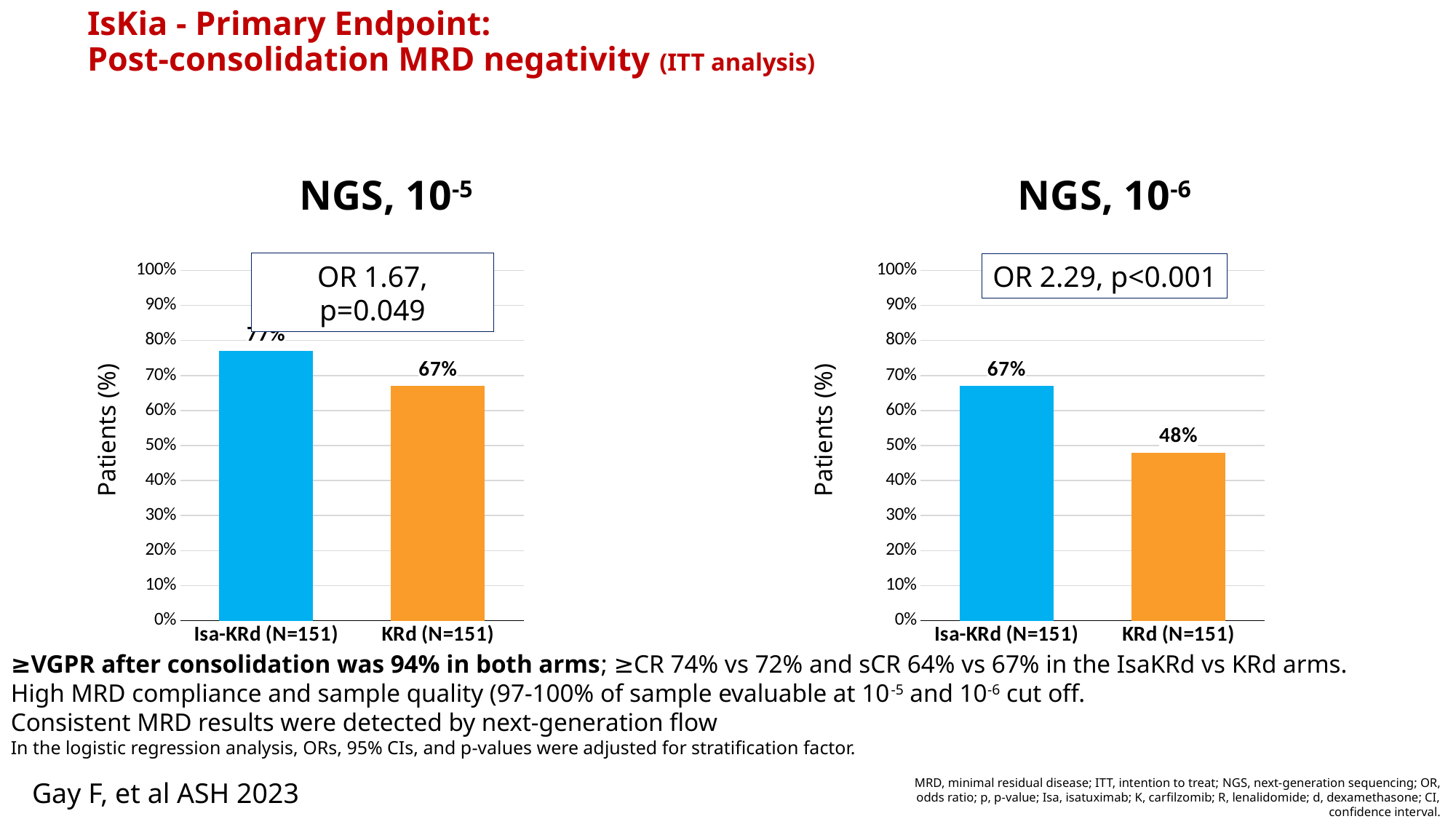
In the NGS, 10^-6 chart, what is the difference between the Isa-KRd (N=151) and KRd (N=151) values? 19% In the NGS, 10^-5 chart, which is larger, the value for Isa-KRd (N=151) or KRd (N=151)? Isa-KRd (N=151) In the NGS, 10^-5 chart, which arm has the lowest value? KRd (N=151) In the NGS, 10^-5 chart, what is the value for KRd (N=151)? 67% In the NGS, 10^-6 chart, which arm has the highest value? Isa-KRd (N=151) What type of chart is the NGS, 10^-5 chart? Bar chart How many bars are shown in the NGS, 10^-6 chart? 2 In the NGS, 10^-6 chart, what is the value for KRd (N=151)? 48% In the NGS, 10^-6 chart, what is the value for Isa-KRd (N=151)? 67% In the NGS, 10^-5 chart, is the value for Isa-KRd (N=151) greater or less than 70%? greater In the NGS, 10^-6 chart, is the value for KRd (N=151) greater or less than 50%? less In the NGS, 10^-5 chart, what is the value for Isa-KRd (N=151)? 77%